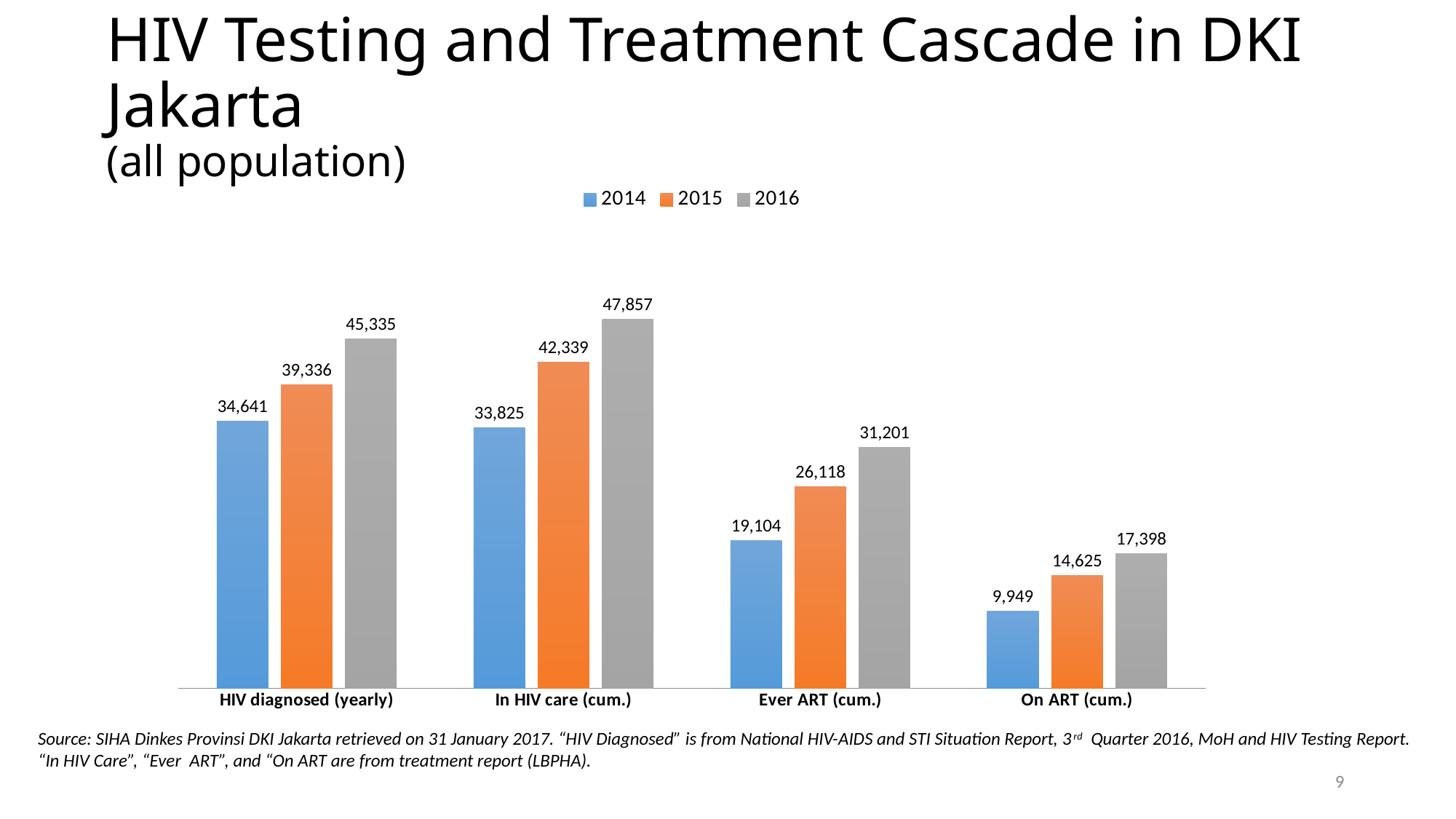
What is the 2016 value for In HIV care (cum.)? 47,857 What is the 2015 value for Ever ART (cum.)? 26,118 Which category has the lowest 2014 value? On ART (cum.) How many series does the legend list? 3 How many categories are shown on the x axis? 4 What is the difference between the 2016 and 2014 values for Ever ART (cum.)? 12,097 Which category has the highest 2016 value? In HIV care (cum.) What is the 2014 value for On ART (cum.)? 9,949 Which is larger: the 2015 value for On ART (cum.) or the 2014 value for Ever ART (cum.)? 2014 value for Ever ART (cum.) What is the 2016 value for HIV diagnosed (yearly)? 45,335 What kind of chart is shown on the slide? Bar chart What is the difference between the 2015 values for HIV diagnosed (yearly) and In HIV care (cum.)? 3,003